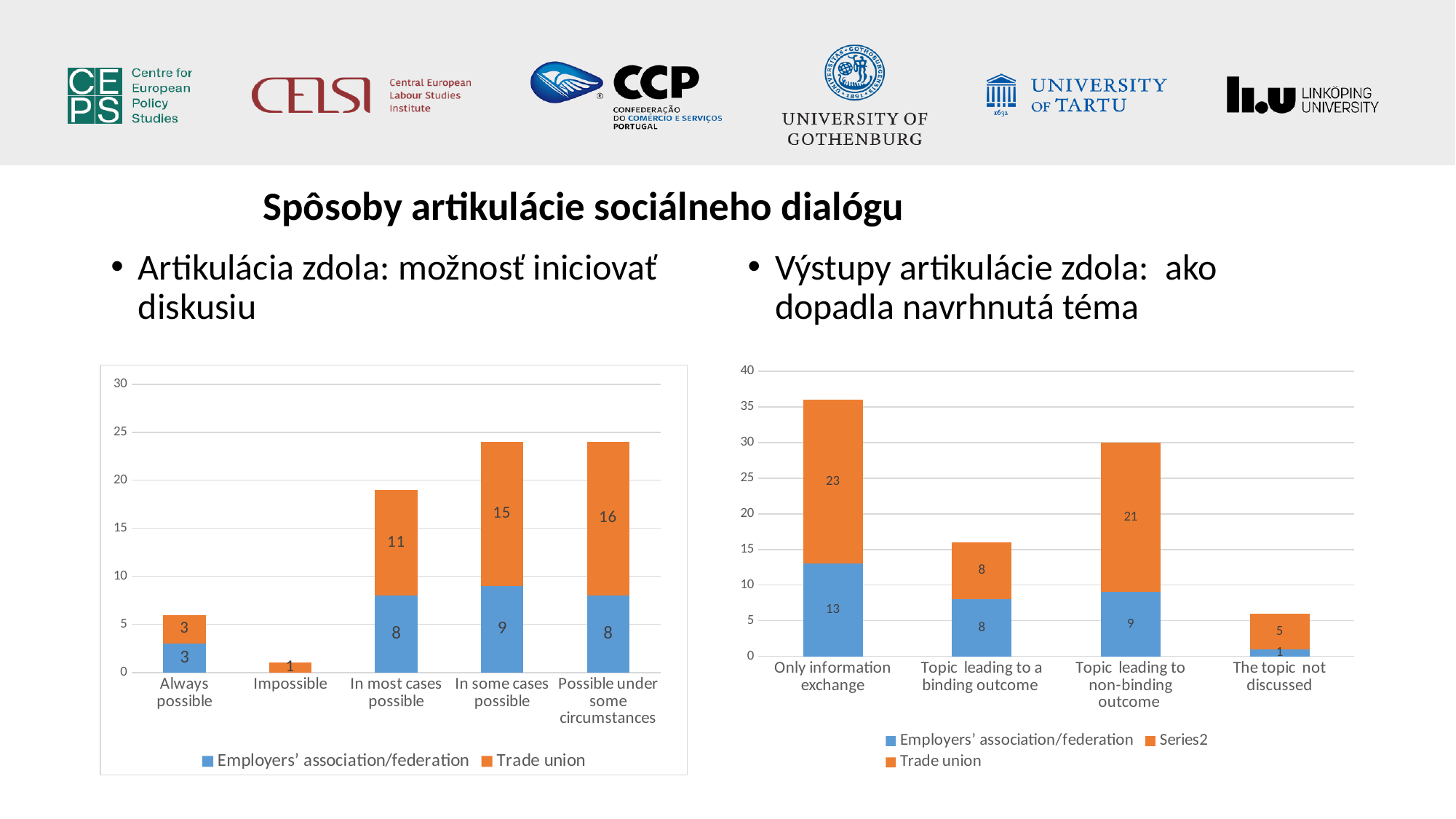
In the left chart, what is the Trade union value for 'In some cases possible'? 15 In the right chart, what is the total of the stacked bar for 'Topic leading to a binding outcome'? 16 In the left chart, how many categories are shown on the x axis? 5 In the left chart, what is the difference between the Trade union values for 'Possible under some circumstances' and 'In most cases possible'? 5 In the left chart, which category has the lowest total stacked bar? Impossible In the left chart, what is the total of the stacked bar for 'Possible under some circumstances'? 24 In the right chart, which category has the highest total stacked bar? Only information exchange What kind of chart is the left chart? Stacked bar chart In the right chart, how many entries does the legend list? 3 In the right chart, what is the Trade union value for 'Only information exchange'? 23 In the right chart, what is the Employers' association/federation value for 'Topic leading to non-binding outcome'? 9 In the left chart, what is the Employers' association/federation value for 'In most cases possible'? 8